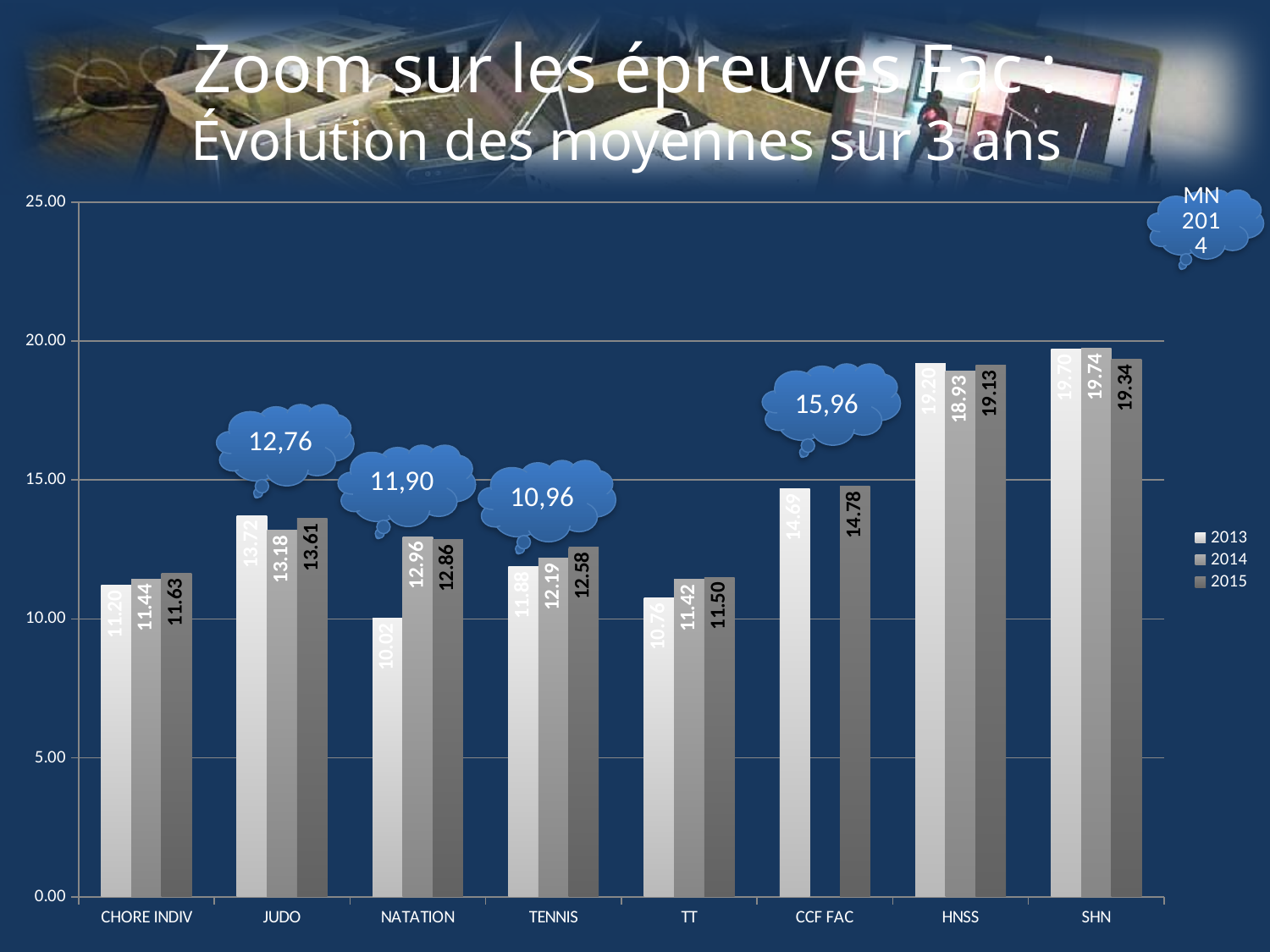
Which years are listed in the chart legend? 2013, 2014, 2015 What is the difference between the 2015 and 2013 values for TENNIS? 0.70 What type of chart is shown on the slide? bar chart What is the value for JUDO in 2015? 13.61 How many series does the legend list? 3 Which category has the highest value in 2014? SHN How many categories are shown on the x axis? 8 Which category has the lowest value in 2013? NATATION What is the value for HNSS in 2014? 18.93 What is the value for NATATION in 2013? 10.02 Which is larger, the 2013 value for TT or the 2013 value for CHORE INDIV? CHORE INDIV Do the values for CHORE INDIV rise or fall from 2013 to 2015? rise